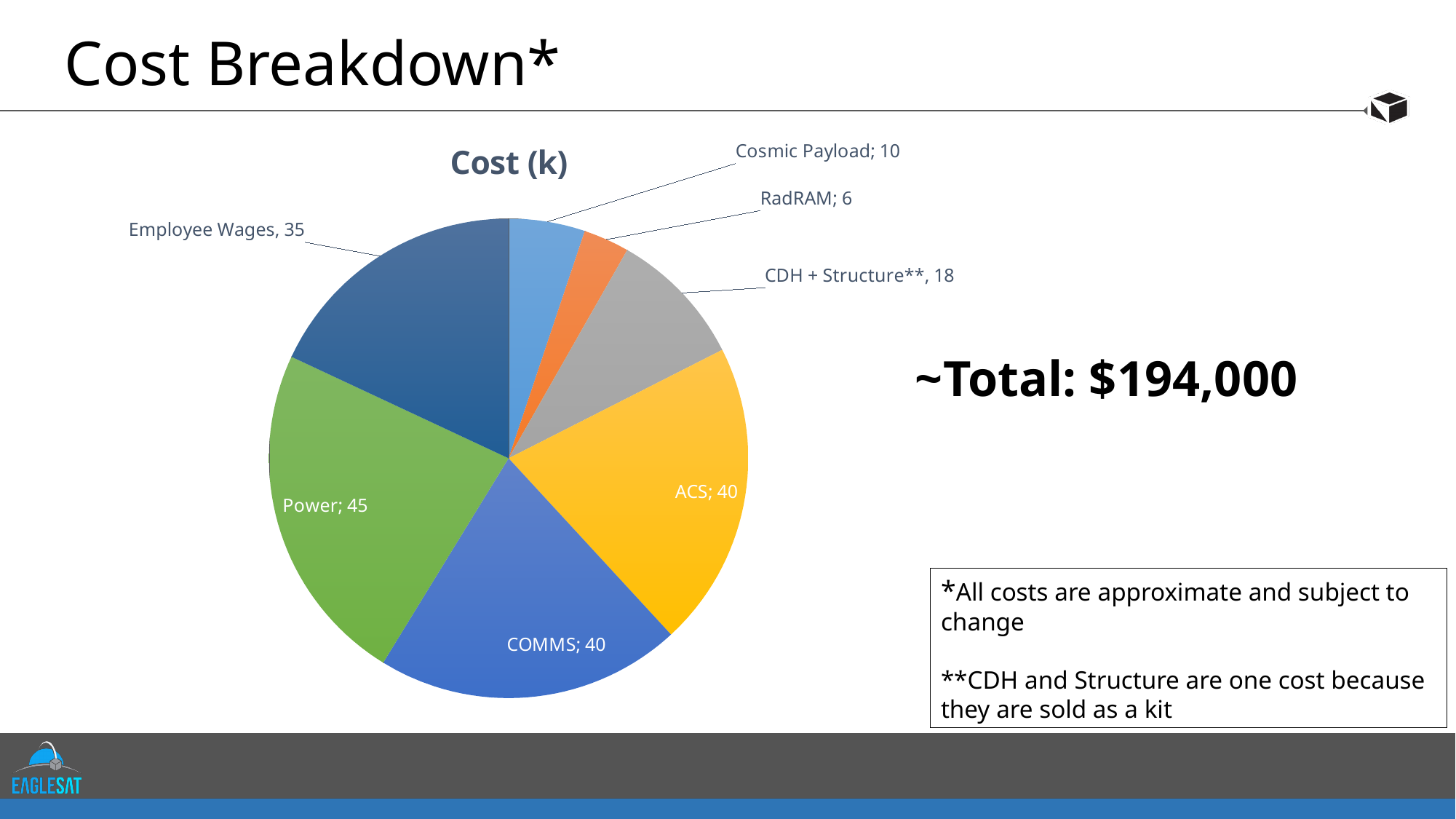
Which category has the smallest slice in the Cost (k) pie chart? RadRAM Which category has the largest slice in the Cost (k) pie chart? Power What is the value for RadRAM in the Cost (k) pie chart? 6 What is the difference between the values for Power and Employee Wages in the Cost (k) pie chart? 10 What is the value for Power in the Cost (k) pie chart? 45 What is the title of the chart? Cost (k) Which is larger in the Cost (k) pie chart, Employee Wages or CDH + Structure**? Employee Wages How many slices does the Cost (k) pie chart have? 7 What is the value for Employee Wages in the Cost (k) pie chart? 35 What type of chart is shown on the slide? pie chart What is the value for Cosmic Payload in the Cost (k) pie chart? 10 What is the value for CDH + Structure** in the Cost (k) pie chart? 18